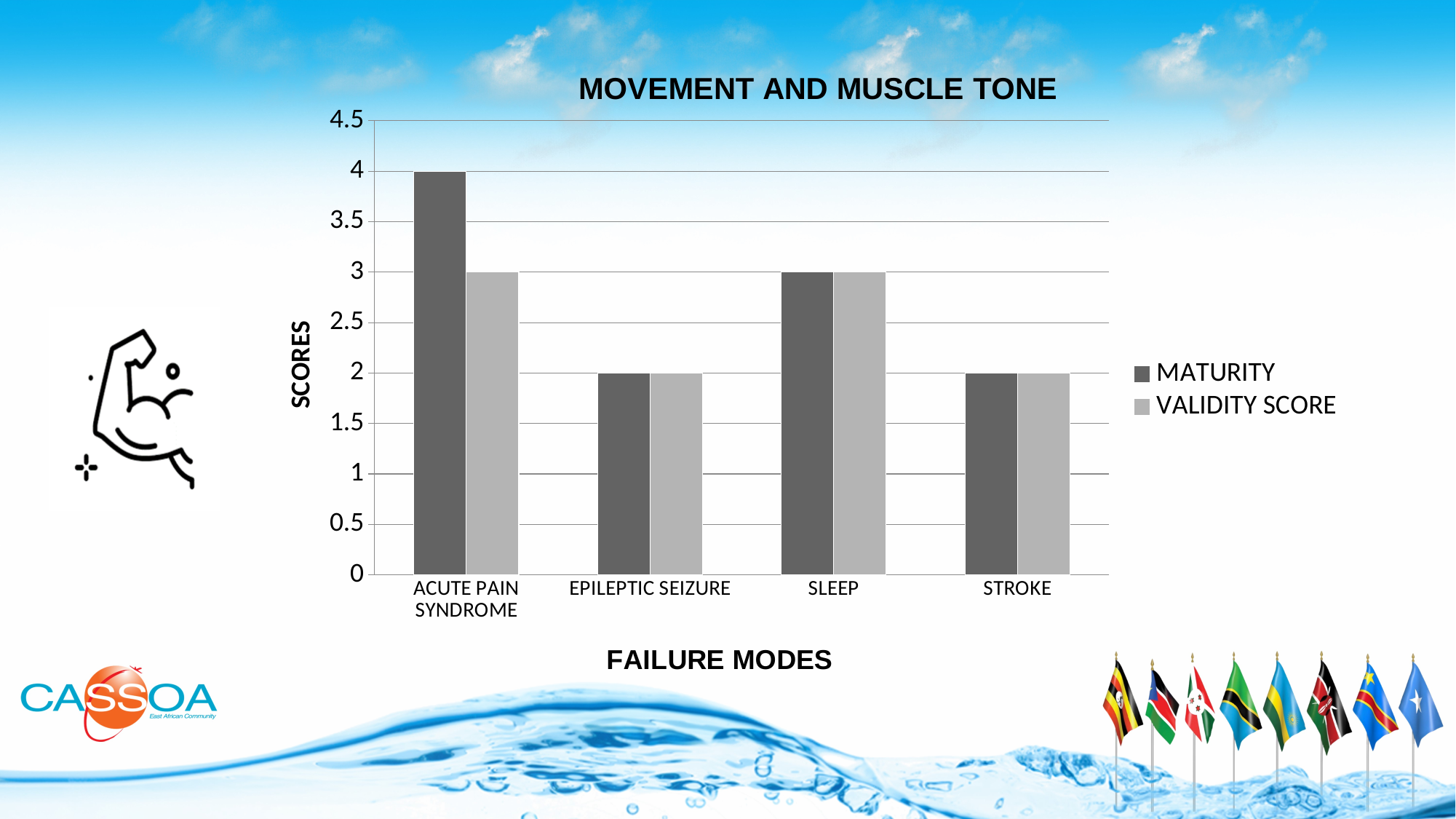
How many series does the legend list? 2 Which failure mode has the highest MATURITY score? ACUTE PAIN SYNDROME How many failure modes are shown on the x axis? 4 What is the MATURITY score for SLEEP? 3 What type of chart is shown on the slide? bar chart What is the difference between the MATURITY score and the VALIDITY SCORE for ACUTE PAIN SYNDROME? 1 What is the chart's title? MOVEMENT AND MUSCLE TONE Is the MATURITY score for EPILEPTIC SEIZURE greater or less than 3? less What is the MATURITY score for ACUTE PAIN SYNDROME? 4 What is the label of the y axis? SCORES What is the VALIDITY SCORE for ACUTE PAIN SYNDROME? 3 Which is larger for STROKE, the MATURITY score or the VALIDITY SCORE, or are they equal? equal